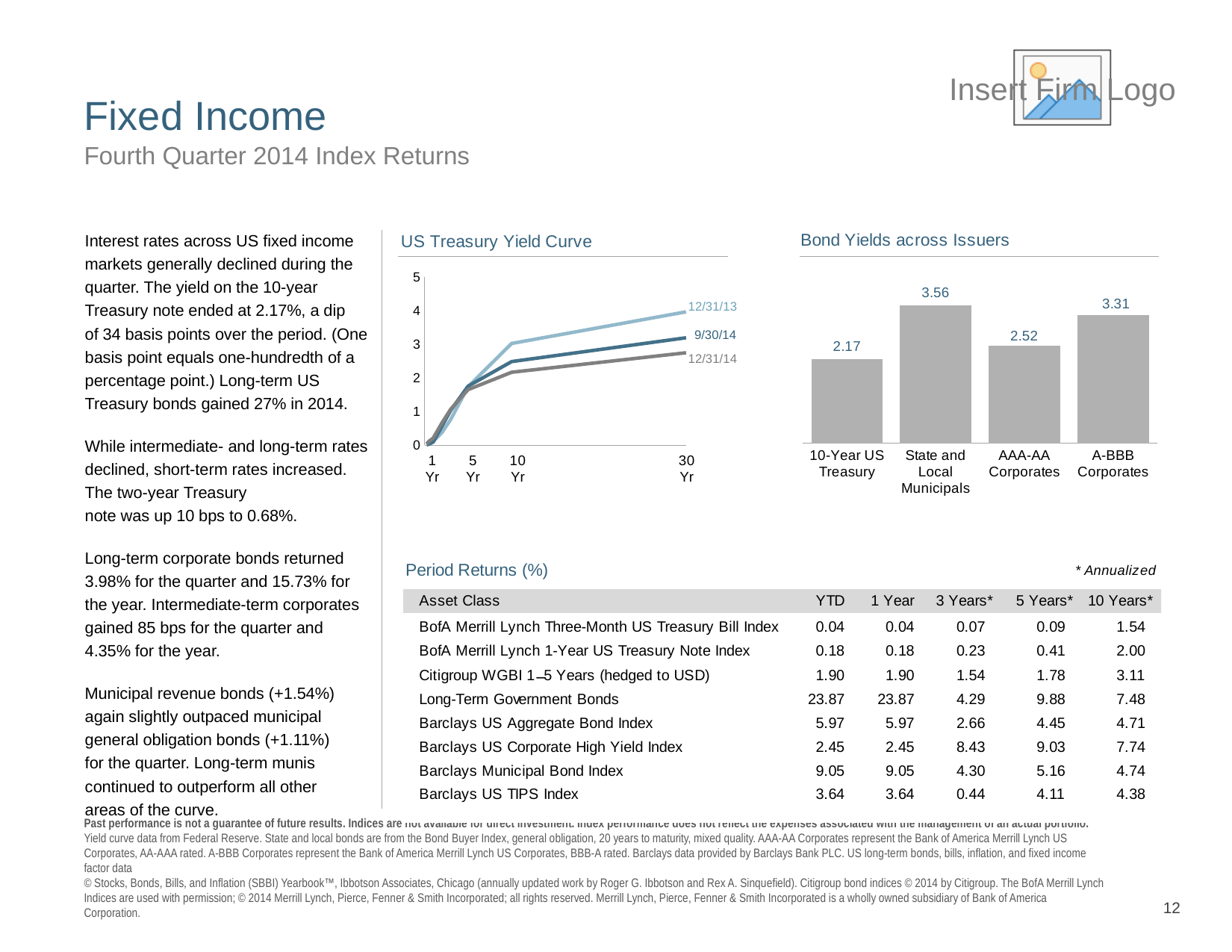
In the US Treasury Yield Curve chart, do the values rise or fall from 1 Yr to 30 Yr? Rise What kind of chart is the Bond Yields across Issuers chart? Bar chart What kind of chart is the US Treasury Yield Curve chart? Line chart In the Bond Yields across Issuers chart, what is the value for 10-Year US Treasury? 2.17 In the Bond Yields across Issuers chart, which category has the lowest value? 10-Year US Treasury How many series are plotted in the US Treasury Yield Curve chart? 3 In the Bond Yields across Issuers chart, what is the value for AAA-AA Corporates? 2.52 In the US Treasury Yield Curve chart, is the 12/31/13 value at 30 Yr greater or less than 3? greater In the Bond Yields across Issuers chart, which category has the highest value? State and Local Municipals In the Bond Yields across Issuers chart, what is the difference between State and Local Municipals and A-BBB Corporates? 0.25 How many categories are shown in the Bond Yields across Issuers chart? 4 In the Bond Yields across Issuers chart, which is larger: AAA-AA Corporates or A-BBB Corporates? A-BBB Corporates